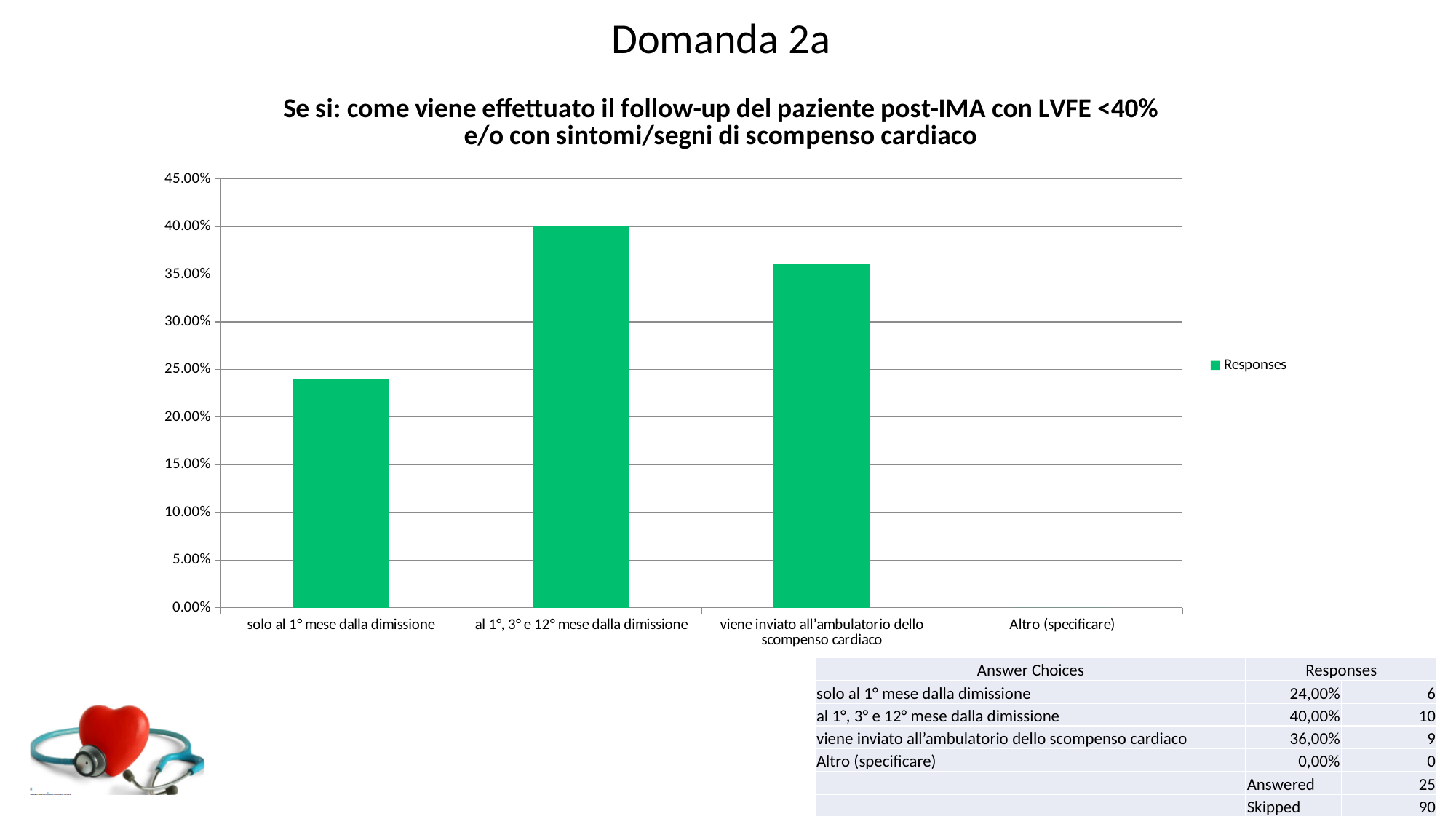
What is the response percentage for 'al 1°, 3° e 12° mese dalla dimissione'? 40,00% How many categories are shown on the x axis of the chart? 4 What is the response percentage for 'solo al 1° mese dalla dimissione'? 24,00% What is the name of the series shown in the chart legend? Responses Which category has the lowest response percentage? Altro (specificare) Which category has the highest response percentage? al 1°, 3° e 12° mese dalla dimissione What type of chart is shown on the slide? bar chart What is the response percentage for 'viene inviato all'ambulatorio dello scompenso cardiaco'? 36,00% Is the value for 'solo al 1° mese dalla dimissione' greater or less than 25.00%? less Which has a larger response percentage: 'viene inviato all'ambulatorio dello scompenso cardiaco' or 'solo al 1° mese dalla dimissione'? viene inviato all'ambulatorio dello scompenso cardiaco How many series does the chart legend list? 1 What is the difference in response percentage between 'al 1°, 3° e 12° mese dalla dimissione' and 'solo al 1° mese dalla dimissione'? 16,00%